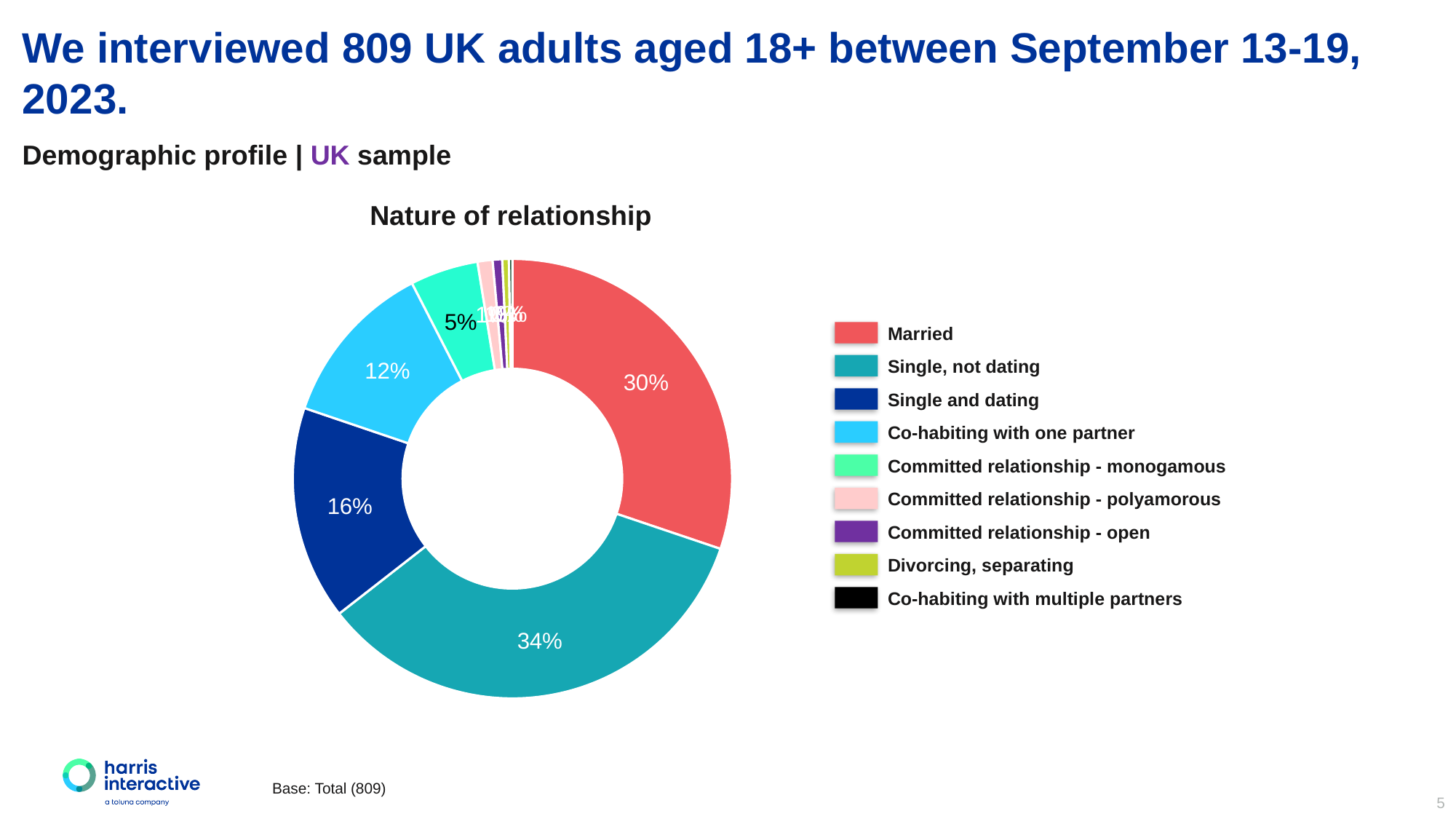
What percentage of the Nature of relationship chart is Married? 30% What percentage is shown for Single and dating? 16% What kind of chart is used to show the Nature of relationship data? Pie (donut) chart What is the difference in percentage points between Single, not dating and Married? 4 What is the title of the chart on the slide? Nature of relationship What is the difference in percentage points between Single and dating and Co-habiting with one partner? 4 What percentage of respondents are Co-habiting with one partner? 12% What percentage is shown for Committed relationship - monogamous? 5% Which is larger, the share for Married or the share for Single and dating? Married How many categories does the legend of the Nature of relationship chart list? 9 Which category has the largest slice in the Nature of relationship chart? Single, not dating What share of respondents are Single, not dating? 34%